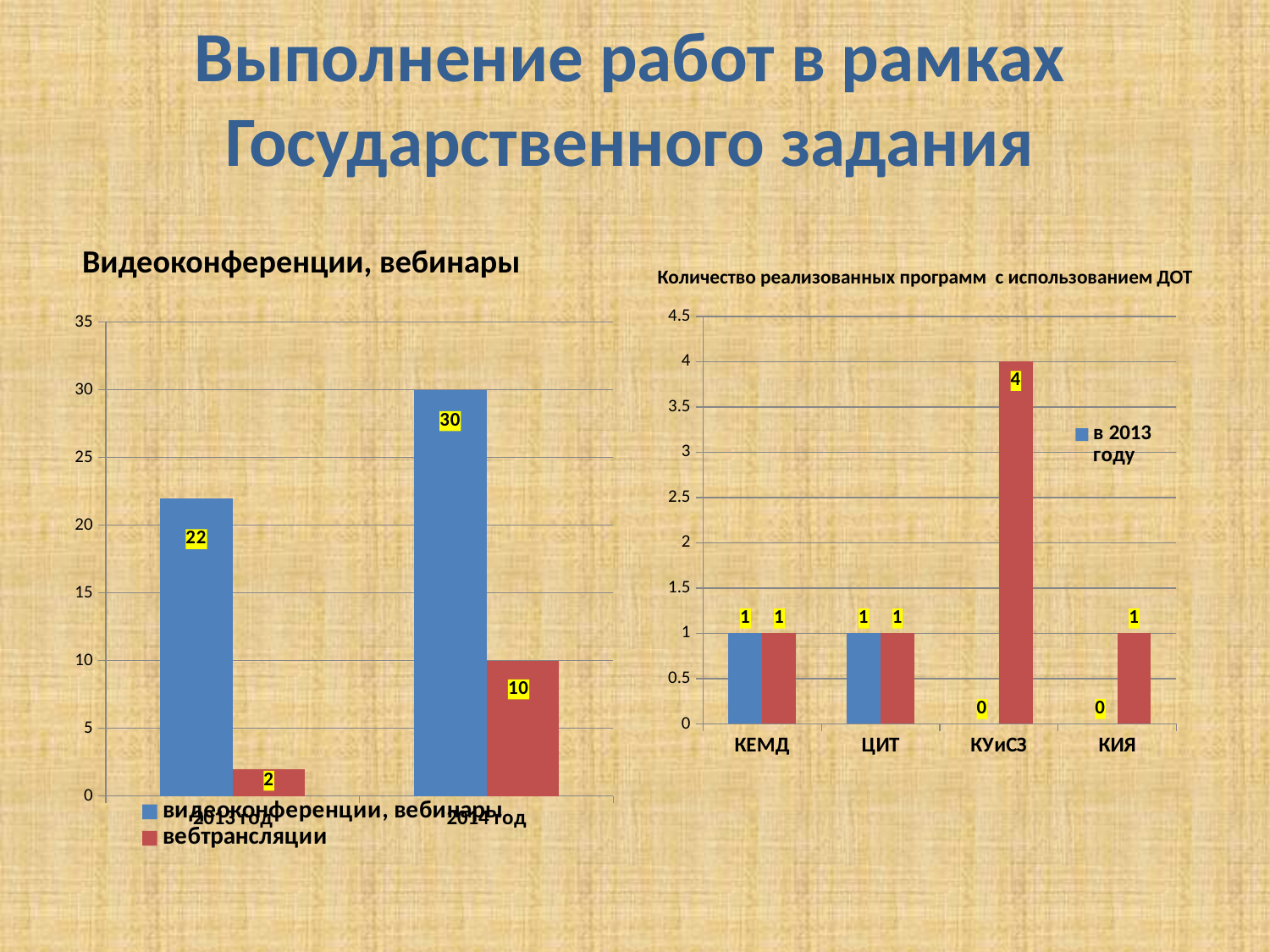
On the chart titled 'Видеоконференции, вебинары', what is the difference between видеоконференции, вебинары and вебтрансляции in 2014 год? 20 On the chart titled 'Видеоконференции, вебинары', do the values for вебтрансляции rise or fall from 2013 год to 2014 год? rise On the chart titled 'Количество реализованных программ с использованием ДОТ', how many categories are shown on the x axis? 4 On the chart titled 'Количество реализованных программ с использованием ДОТ', what is the value for КУиСЗ in the series 'в 2013 году'? 0 On the chart titled 'Количество реализованных программ с использованием ДОТ', which category has the highest red bar? КУиСЗ On the chart titled 'Видеоконференции, вебинары', what is the value for вебтрансляции in 2013 год? 2 On the chart titled 'Видеоконференции, вебинары', what is the value for вебтрансляции in 2014 год? 10 On the chart titled 'Видеоконференции, вебинары', what is the value for видеоконференции, вебинары in 2013 год? 22 What kind of chart is the chart titled 'Количество реализованных программ с использованием ДОТ'? bar chart On the chart titled 'Количество реализованных программ с использованием ДОТ', what is the value of the red bar for КУиСЗ? 4 On the chart titled 'Видеоконференции, вебинары', by how much did видеоконференции, вебинары increase from 2013 год to 2014 год? 8 On the chart titled 'Видеоконференции, вебинары', how many series does the legend list? 2